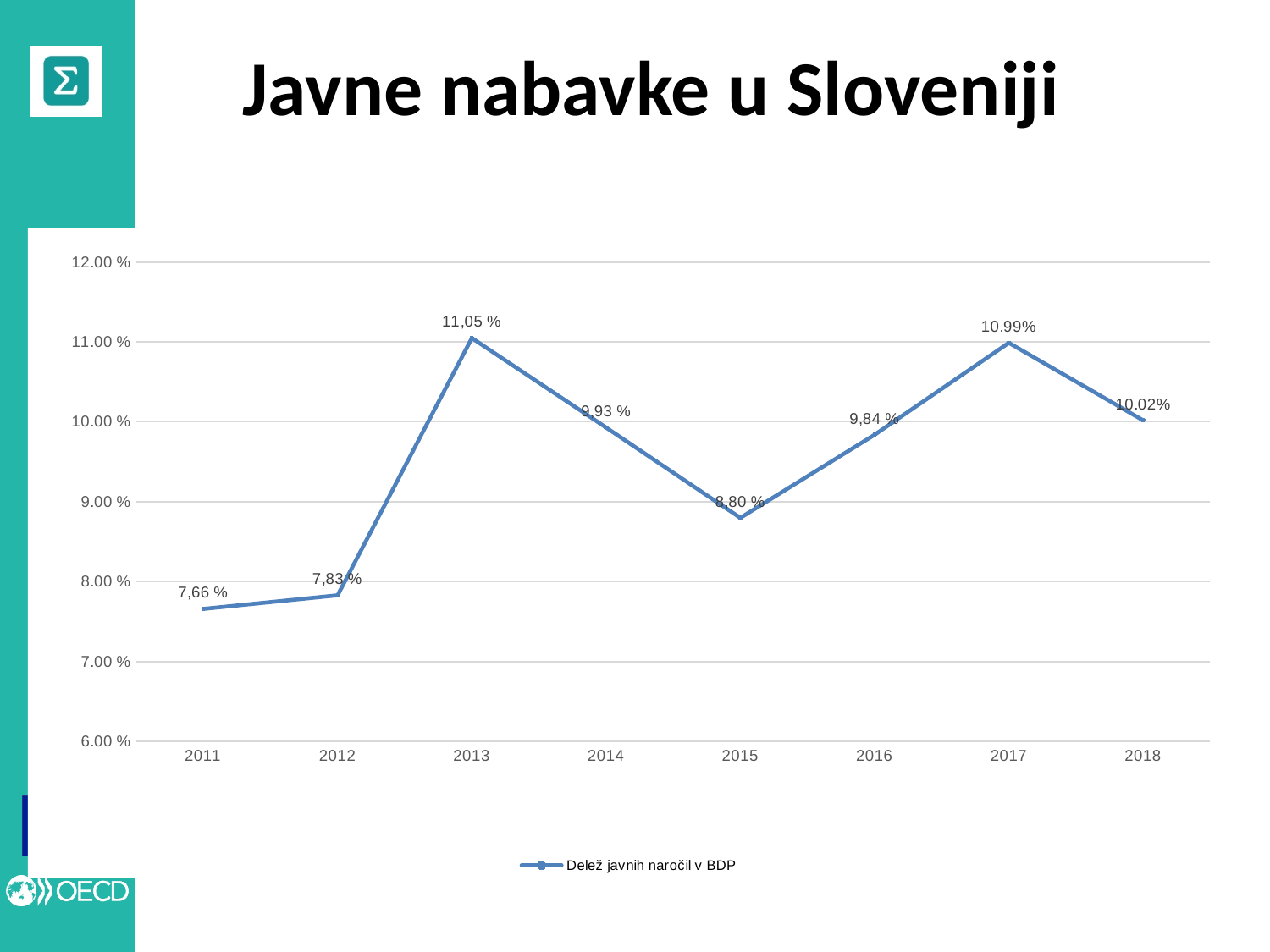
What is the value for 2011? 7,66 % What is the value for 2015? 8.80 % Which year has the lowest value? 2011 What kind of chart is shown on the slide? line chart Does the value rise or fall from 2013 to 2015? fall What is the difference between the values for 2017 and 2018? 0.97 percentage points What is the value for 2017? 10.99% What is the legend entry for the plotted series? Delež javnih naročil v BDP Which year has the highest value? 2013 What is the value for 2013? 11,05 % Is the value for 2016 greater or less than 2014? less How many years are plotted on the chart? 8